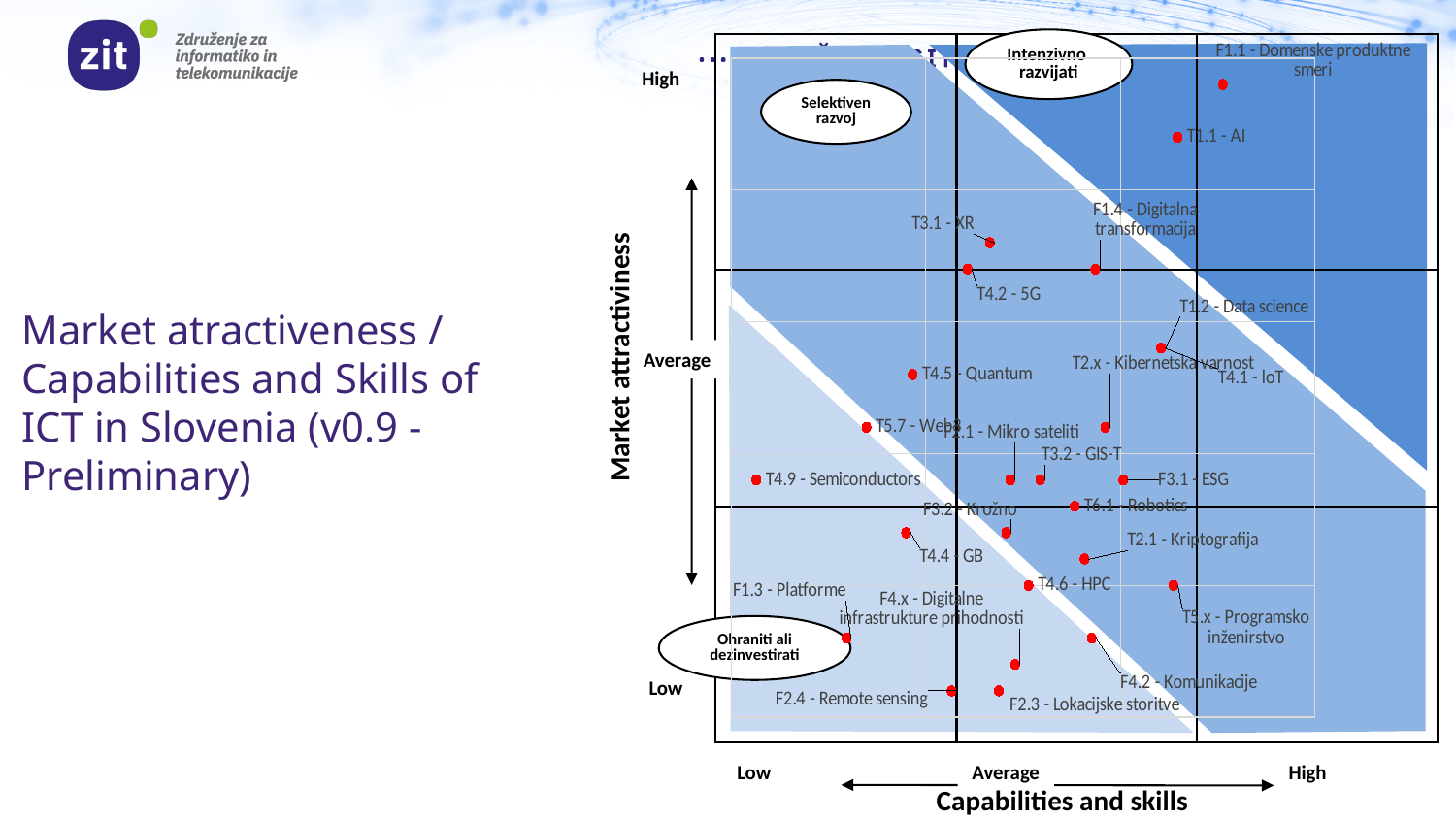
Which point has higher market attractiveness, T4.5 - Quantum or T4.6 - HPC? T4.5 - Quantum Which point is plotted furthest to the right on the Capabilities and skills axis? F1.1 - Domenske produktne smeri What is the title of the vertical axis of the chart? Market attractiveness Is T5.x - Programsko inženirstvo plotted to the left or right of the Average mark on the Capabilities and skills axis? right Is T4.9 - Semiconductors plotted to the left or right of the Average mark on the Capabilities and skills axis? left Is F2.4 - Remote sensing plotted above or below the Average mark on the Market attractiveness axis? below Which point is further right on the Capabilities and skills axis, T1.1 - AI or T3.1 - XR? T1.1 - AI What kind of chart is shown on the slide? scatter chart Which point has higher market attractiveness, T1.1 - AI or T4.9 - Semiconductors? T1.1 - AI Which point is plotted highest on the Market attractiveness axis? F1.1 - Domenske produktne smeri What is the title of the horizontal axis of the chart? Capabilities and skills